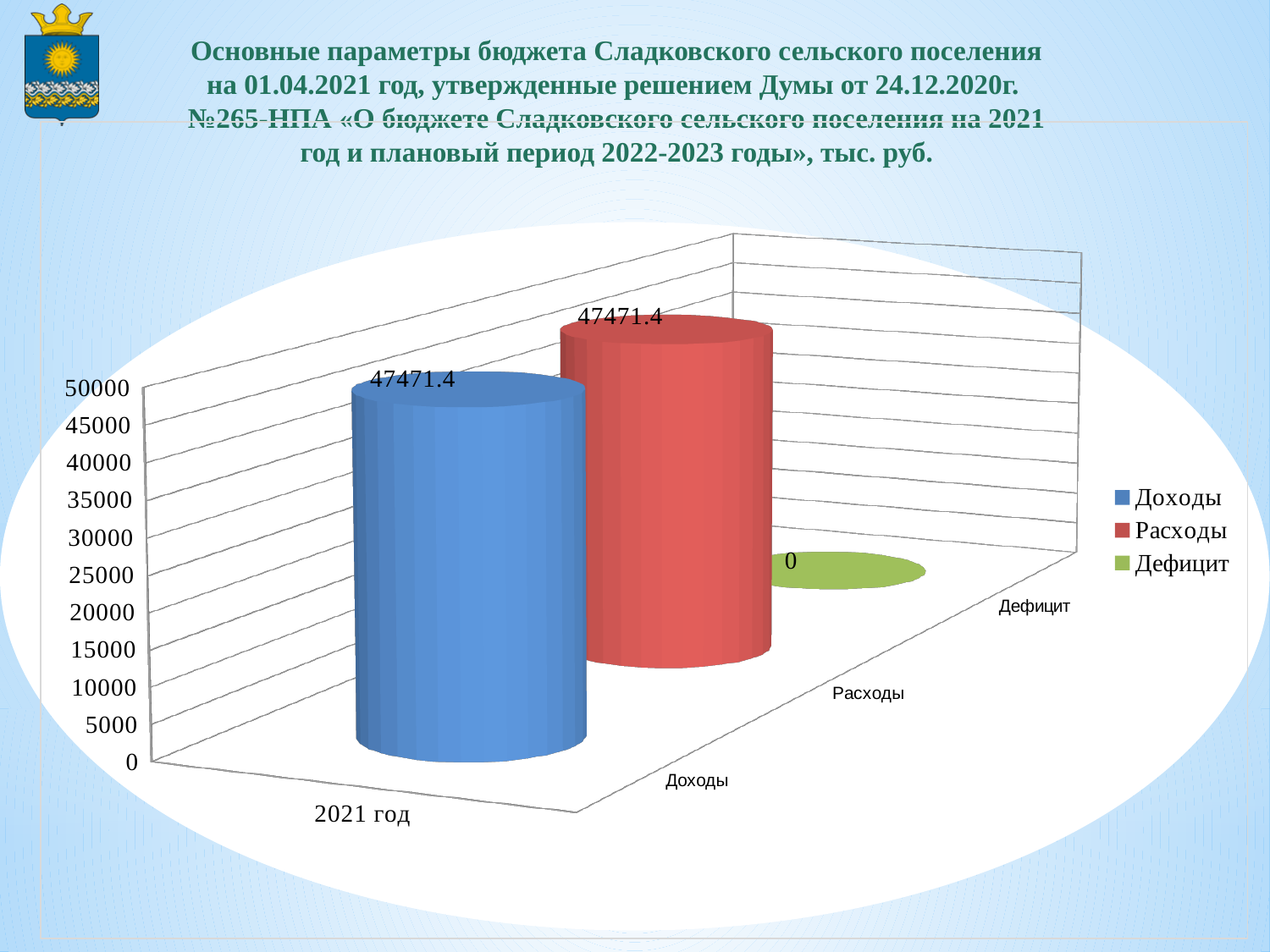
What is the difference between Доходы and Расходы in 2021 год? 0 Is the value for Расходы greater or less than 40000? greater What is the difference between Доходы and Дефицит in 2021 год? 47471.4 What is the value for Доходы in 2021 год? 47471.4 Which series has the lowest value in 2021 год? Дефицит What colour represents Дефицит in the legend? green What is the value for Дефицит in 2021 год? 0 Is the value for Доходы greater or less than 45000? greater What is the value for Расходы in 2021 год? 47471.4 How many series does the legend list? 3 Which is larger, Расходы or Дефицит? Расходы What kind of chart is shown on the slide? bar chart